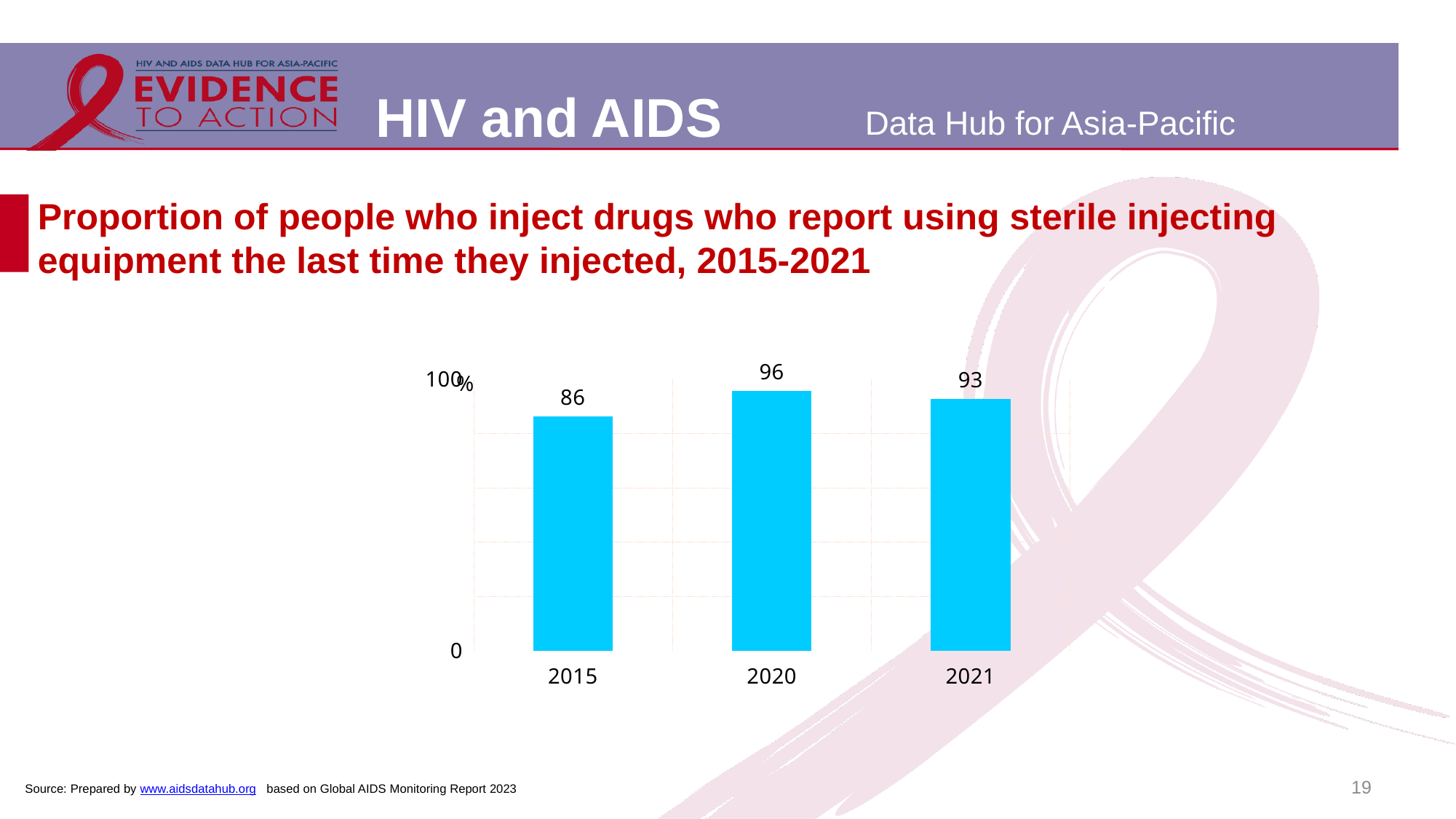
Which year has the lowest value? 2015 What kind of chart is shown on the slide? bar chart What is the difference between the values for 2020 and 2021? 3 What is the value for 2015? 86 What is the difference between the values for 2020 and 2015? 10 Does the value rise or fall from 2015 to 2020? rise How many years are shown on the x axis? 3 Which is larger, the value for 2021 or the value for 2015? 2021 Which year has the highest value? 2020 What is the value for 2021? 93 What is the value for 2020? 96 What is the maximum value shown on the y axis? 100